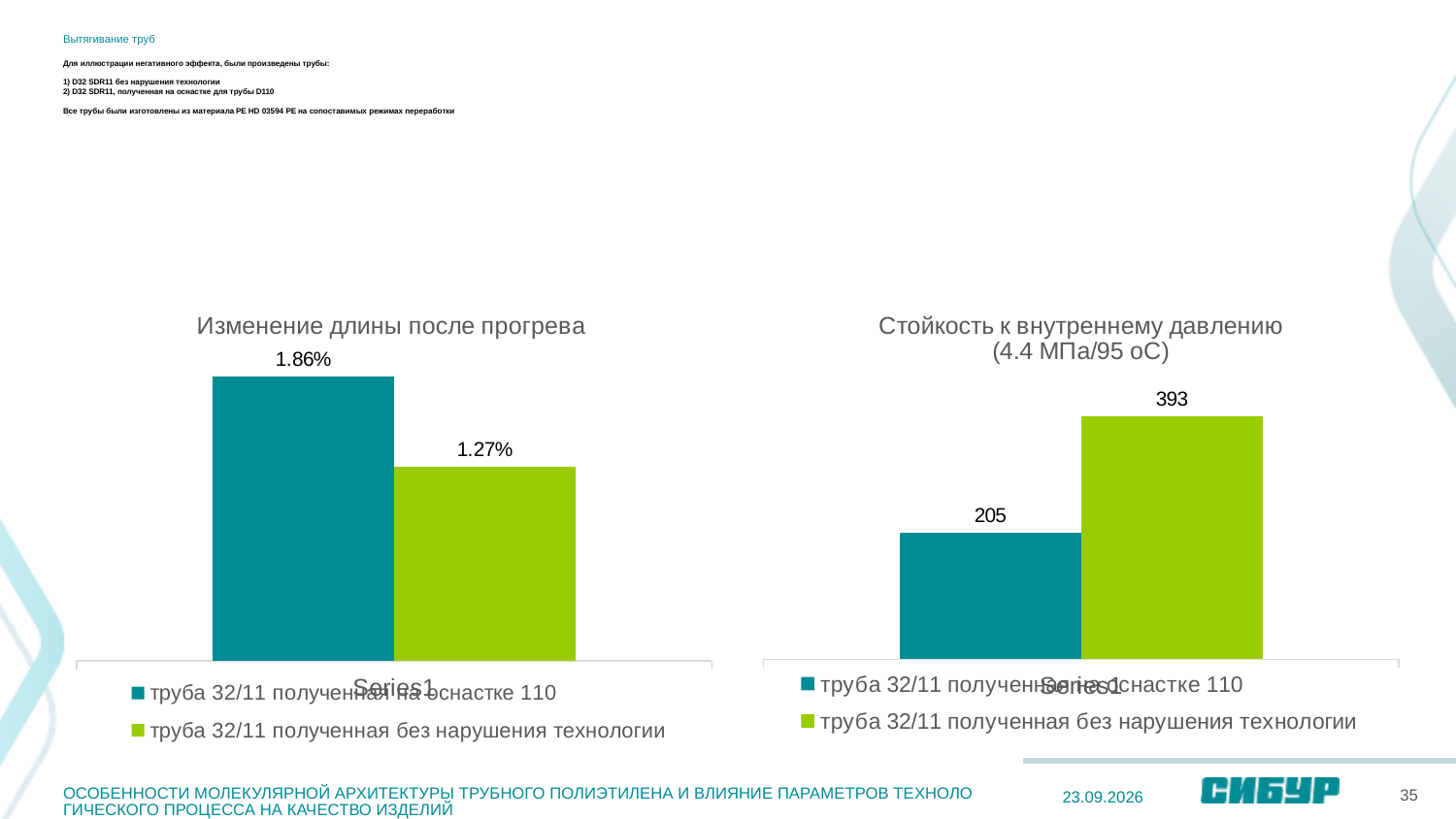
In the chart titled "Изменение длины после прогрева", what is the value for труба 32/11 полученная на оснастке 110? 1.86% In the chart titled "Стойкость к внутреннему давлению (4.4 МПа/95 оС)", what is the difference between the two bars? 188 How many series does the legend of the chart titled "Стойкость к внутреннему давлению (4.4 МПа/95 оС)" list? 2 What kind of chart is the chart titled "Изменение длины после прогрева"? bar chart In the chart titled "Изменение длины после прогрева", what is the difference between the two bars? 0.59% In the chart titled "Изменение длины после прогрева", which series has the higher value? труба 32/11 полученная на оснастке 110 In the chart titled "Стойкость к внутреннему давлению (4.4 МПа/95 оС)", which series has the lower value? труба 32/11 полученная на оснастке 110 In the chart titled "Стойкость к внутреннему давлению (4.4 МПа/95 оС)", which is larger: the value for труба 32/11 полученная без нарушения технологии or the value for труба 32/11 полученная на оснастке 110? труба 32/11 полученная без нарушения технологии In the chart titled "Изменение длины после прогрева", what is the value for труба 32/11 полученная без нарушения технологии? 1.27% In the chart titled "Стойкость к внутреннему давлению (4.4 МПа/95 оС)", what is the value for труба 32/11 полученная на оснастке 110? 205 In the chart titled "Изменение длины после прогрева", what colour is the bar for труба 32/11 полученная без нарушения технологии? green In the chart titled "Стойкость к внутреннему давлению (4.4 МПа/95 оС)", what is the value for труба 32/11 полученная без нарушения технологии? 393